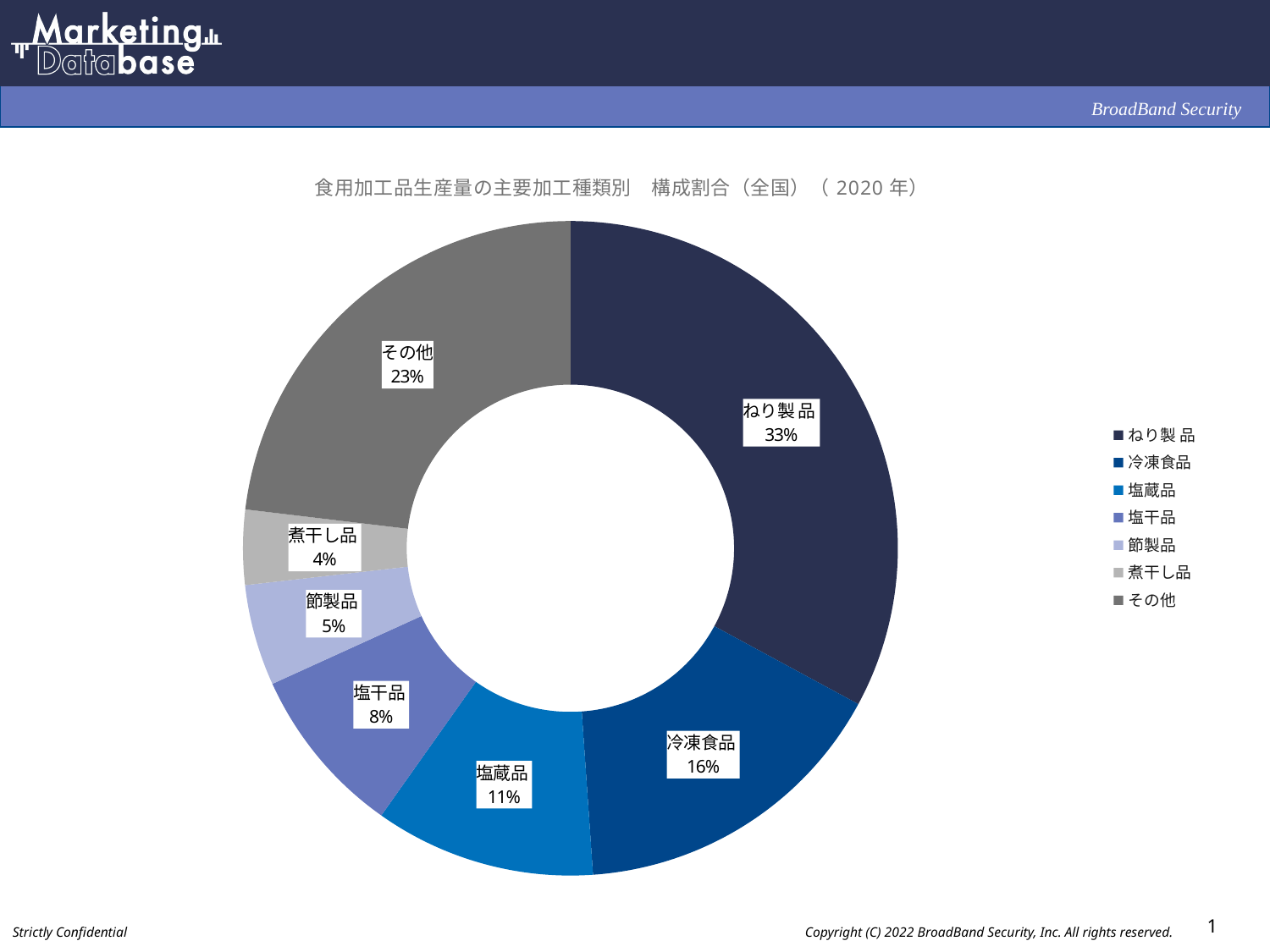
What kind of chart is shown on the slide? Pie chart (doughnut) What is the difference in percentage points between ねり製品 and その他? 10 What share of the chart does ねり製品 account for? 33% Which is larger, 冷凍食品 or 塩蔵品? 冷凍食品 Which category has the smallest share? 煮干し品 What is the title of the chart? 食用加工品生産量の主要加工種類別 構成割合（全国）（2020年） What is the value shown for 冷凍食品? 16% What is the difference in percentage points between 塩干品 and 節製品? 3 What is the value for 煮干し品? 4% Which category has the largest share? ねり製品 What percentage is shown for 塩蔵品? 11% How many categories are shown in the chart? 7